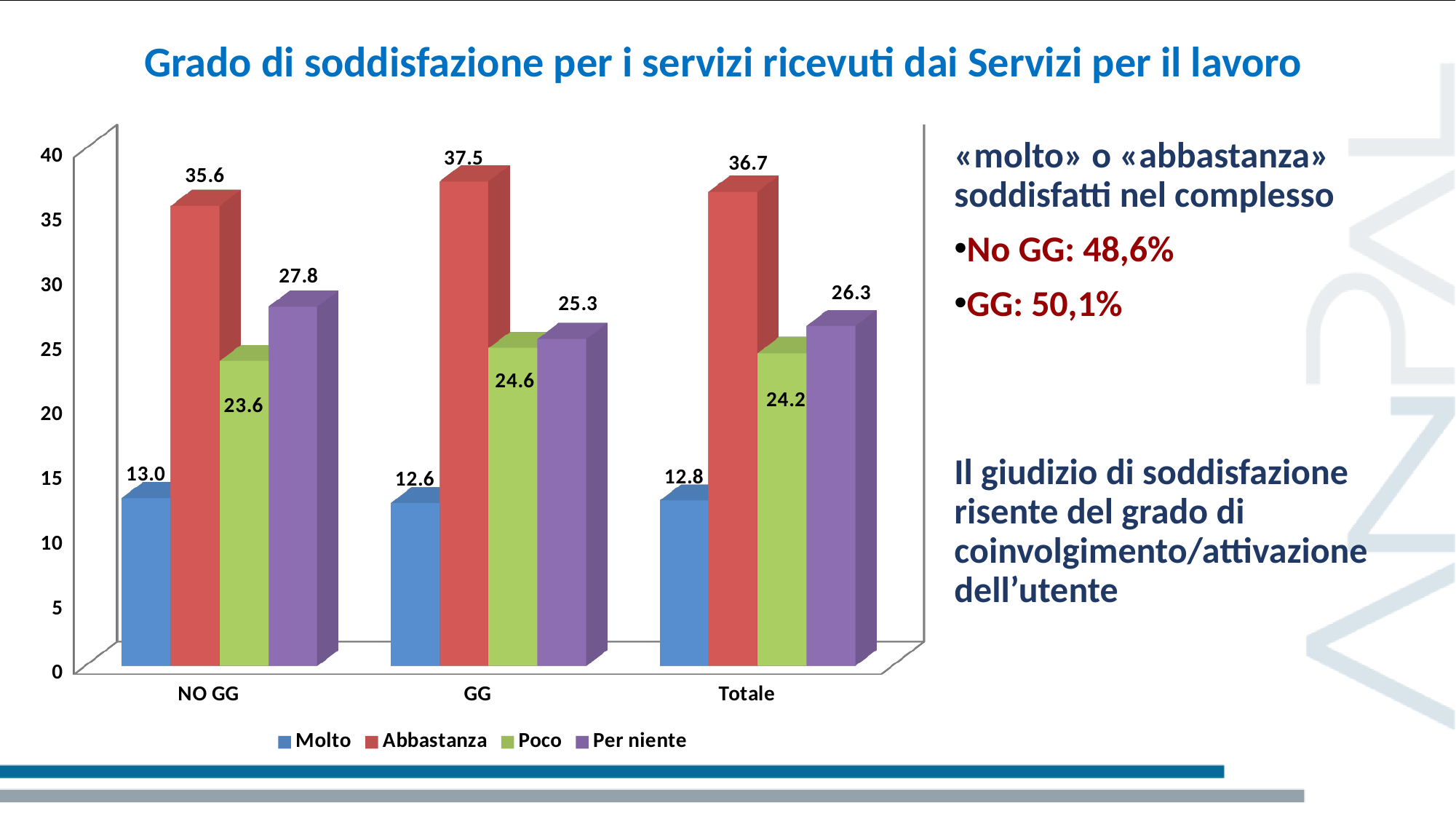
How many categories are shown on the x axis? 3 Which is larger, the Per niente value for NO GG or for GG? NO GG What is the value for Poco in the GG category? 24.6 How many series does the legend list? 4 Which series has the highest value in the NO GG category? Abbastanza What is the value for Abbastanza in the GG category? 37.5 What is the difference between the Abbastanza values for GG and NO GG? 1.9 Is the value for Abbastanza in the Totale category greater or less than 30? greater What is the value for Molto in the NO GG category? 13.0 What is the value for Per niente in the Totale category? 26.3 Which series has the lowest value in the Totale category? Molto What kind of chart is shown on the slide? Bar chart